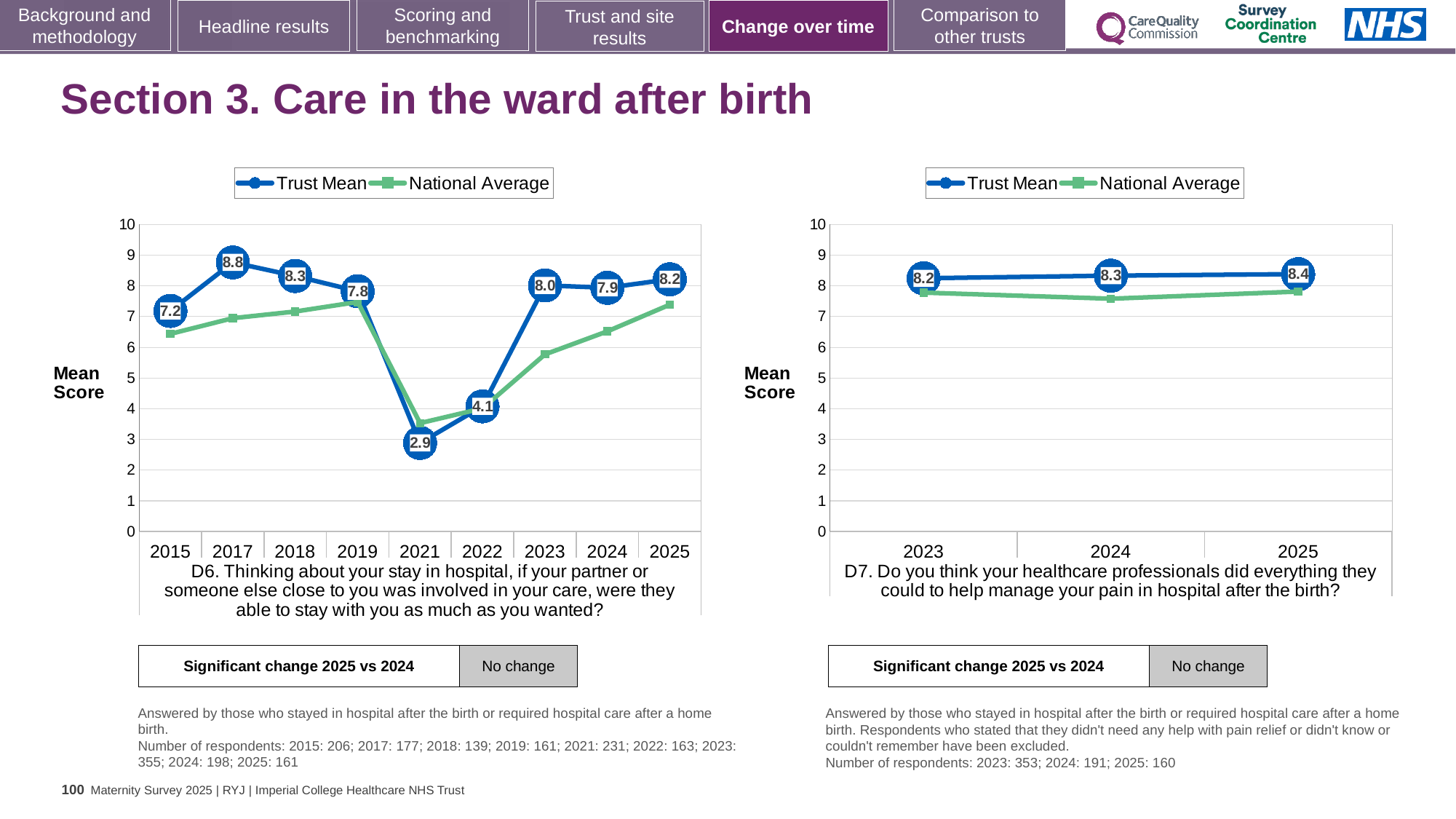
In the D6 chart on the left, which year has the lowest Trust Mean score? 2021 In the D6 chart on the left, is the National Average for 2021 greater or less than 5? less In the D7 chart on the right, what is the Trust Mean score for 2024? 8.3 In the D7 chart on the right, does the Trust Mean rise or fall from 2023 to 2025? rise How many series does the legend of the D7 chart on the right list? 2 What kind of chart is the D7 chart on the right? line chart In the D6 chart on the left, which year has the highest Trust Mean score? 2017 In the D6 chart on the left, what is the Trust Mean score for 2025? 8.2 In the D6 chart on the left, what is the Trust Mean score for 2021? 2.9 In the D6 chart on the left, what is the difference between the Trust Mean scores for 2017 and 2021? 5.9 In the D7 chart on the right, is the Trust Mean for 2025 larger or smaller than the National Average for 2025? larger How many years are plotted on the x axis of the D6 chart on the left? 9